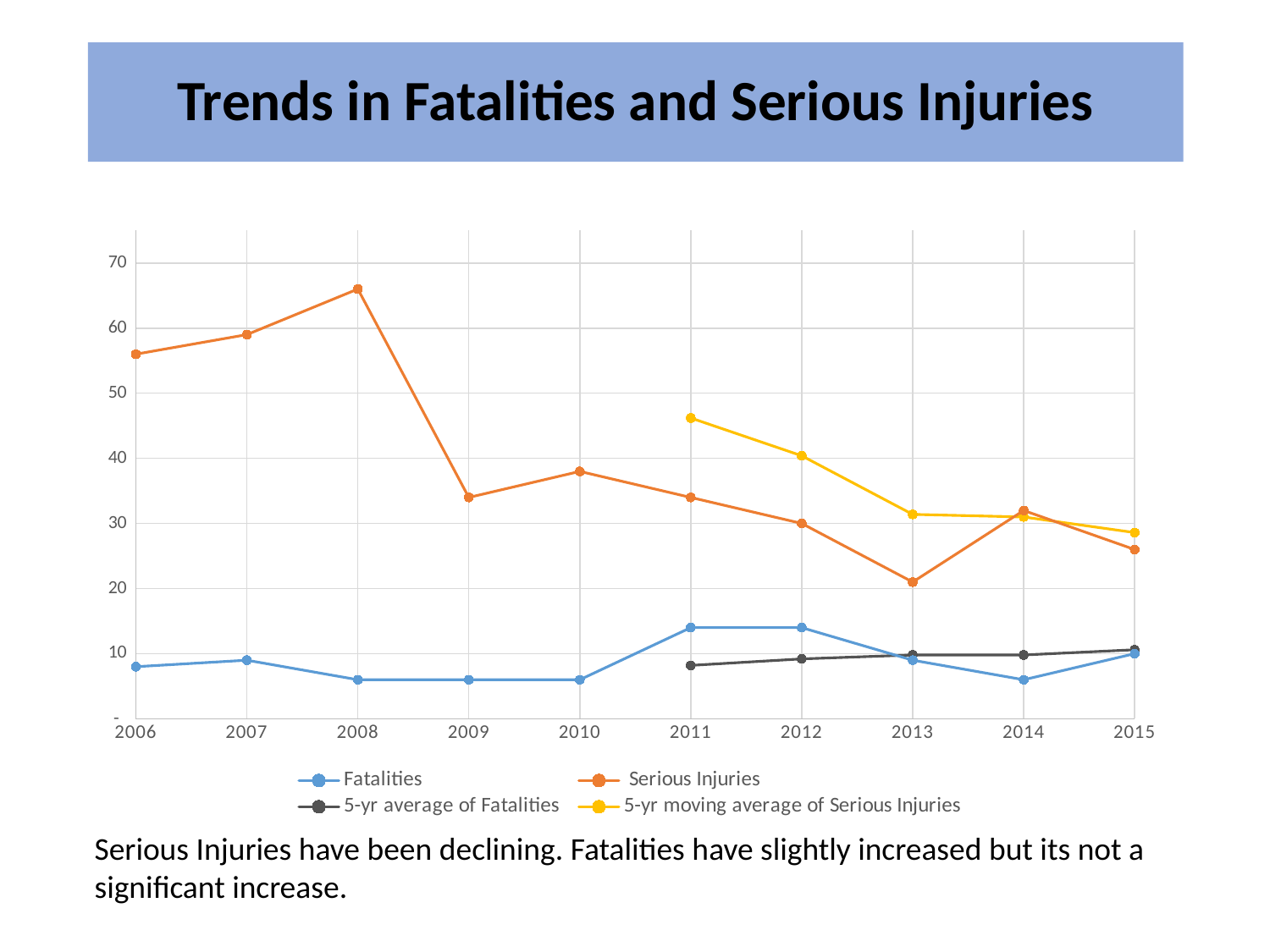
Is the Fatalities value for 2011 greater or less than 10? greater Which is larger, the Serious Injuries value for 2006 or for 2010? 2006 How many series does the legend list? 4 In which year is the Serious Injuries value highest? 2008 What kind of chart is shown on the slide? line chart In which year is the Serious Injuries value lowest? 2013 Does the 5-yr moving average of Serious Injuries rise or fall from 2011 to 2015? fall How many years are shown on the x axis? 10 Is the Serious Injuries value for 2009 greater or less than 40? less Is the 5-yr moving average of Serious Injuries for 2011 greater or less than 40? greater What is the title of the chart? Trends in Fatalities and Serious Injuries